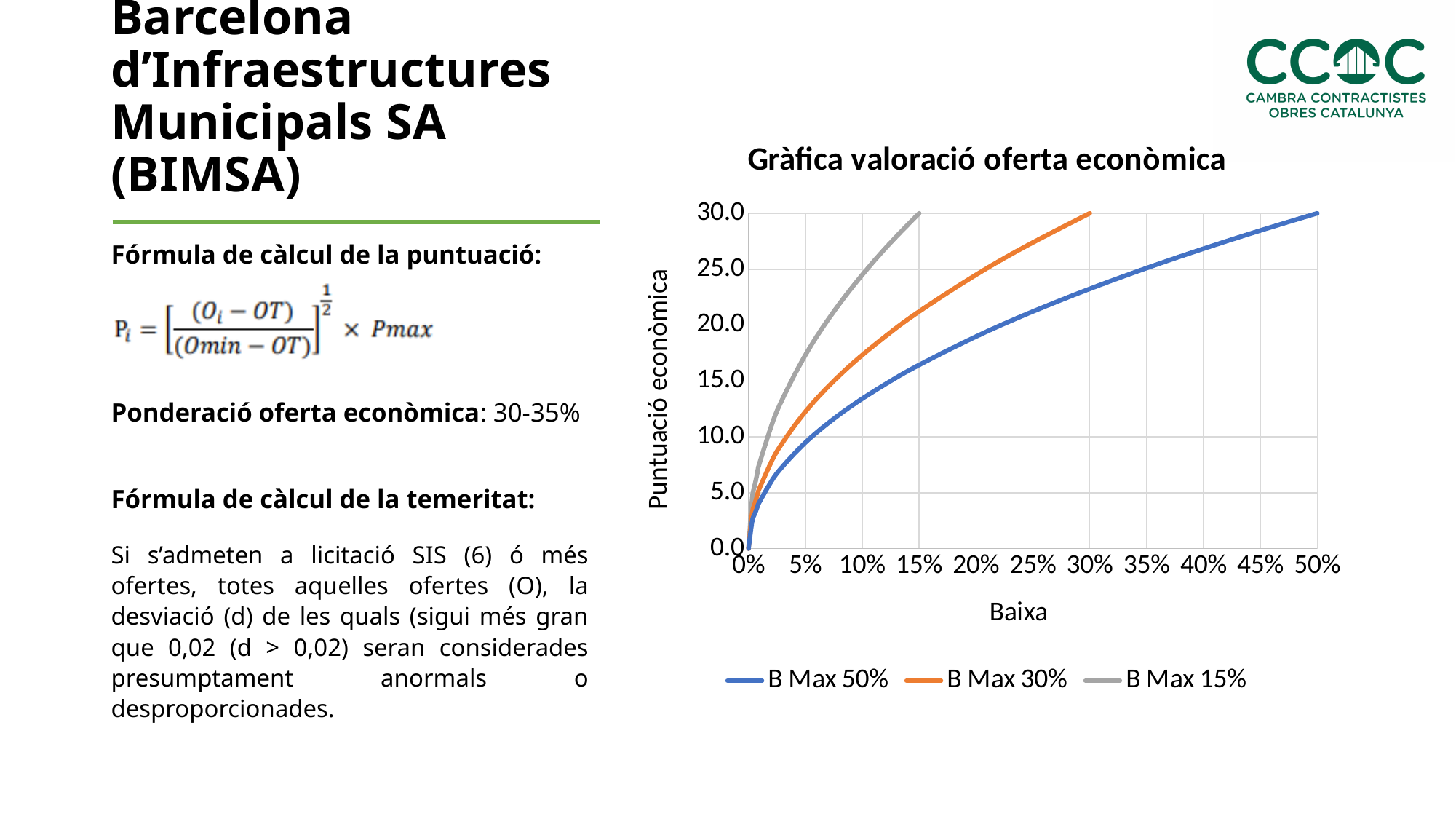
At a Baixa of 5%, is the value of the B Max 15% series greater or less than 15.0? greater What kind of chart is shown on the slide? line chart What is the title of the chart? Gràfica valoració oferta econòmica At a Baixa of 10%, which series has the lowest Puntuació econòmica? B Max 50% At a Baixa of 10%, which series has the highest Puntuació econòmica? B Max 15% At what Baixa value does the B Max 30% series reach 30.0? 30% At what Baixa value does the B Max 15% series reach 30.0? 15% What is the label of the vertical axis of the chart? Puntuació econòmica At a Baixa of 20%, is the value of the B Max 50% series greater or less than 20.0? less How many series does the legend of the chart list? 3 Do the values of the B Max 50% series rise or fall as Baixa increases? rise At what Baixa value does the B Max 50% series reach 30.0? 50%